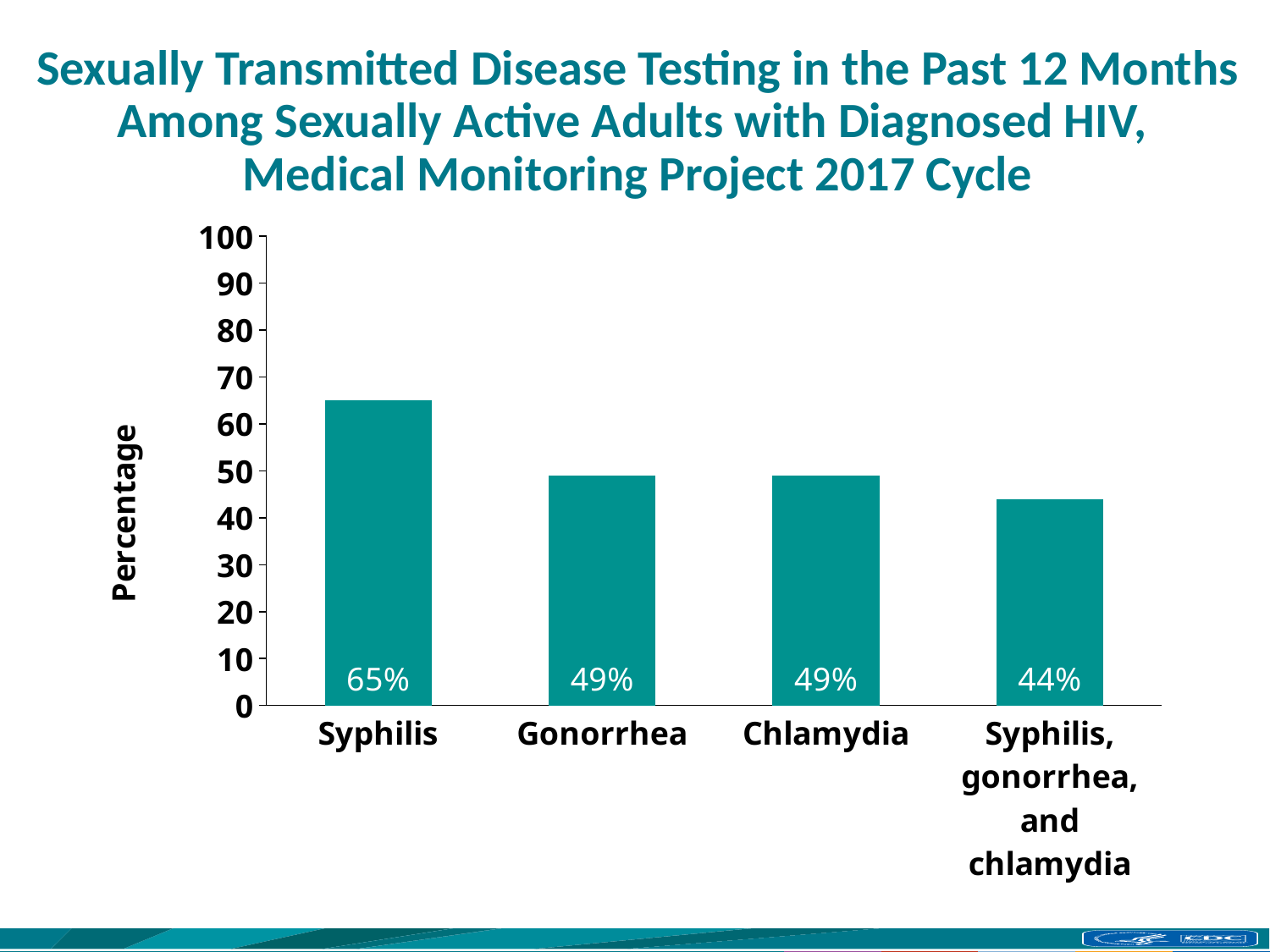
What is the value shown for Gonorrhea? 49% What percentage of sexually active adults with diagnosed HIV were tested for syphilis in the past 12 months? 65% Which category has the lowest percentage? Syphilis, gonorrhea, and chlamydia Which category has the highest percentage? Syphilis What is the value shown for Chlamydia? 49% Which is larger, the value for Syphilis or the value for Chlamydia? Syphilis What percentage were tested for syphilis, gonorrhea, and chlamydia? 44% What is the difference in percentage points between Chlamydia and Syphilis, gonorrhea, and chlamydia? 5 Is the value for Syphilis greater or less than 60? greater What is the difference in percentage points between Syphilis and Gonorrhea? 16 How many categories are shown on the x axis? 4 What kind of chart is shown on the slide? Bar chart